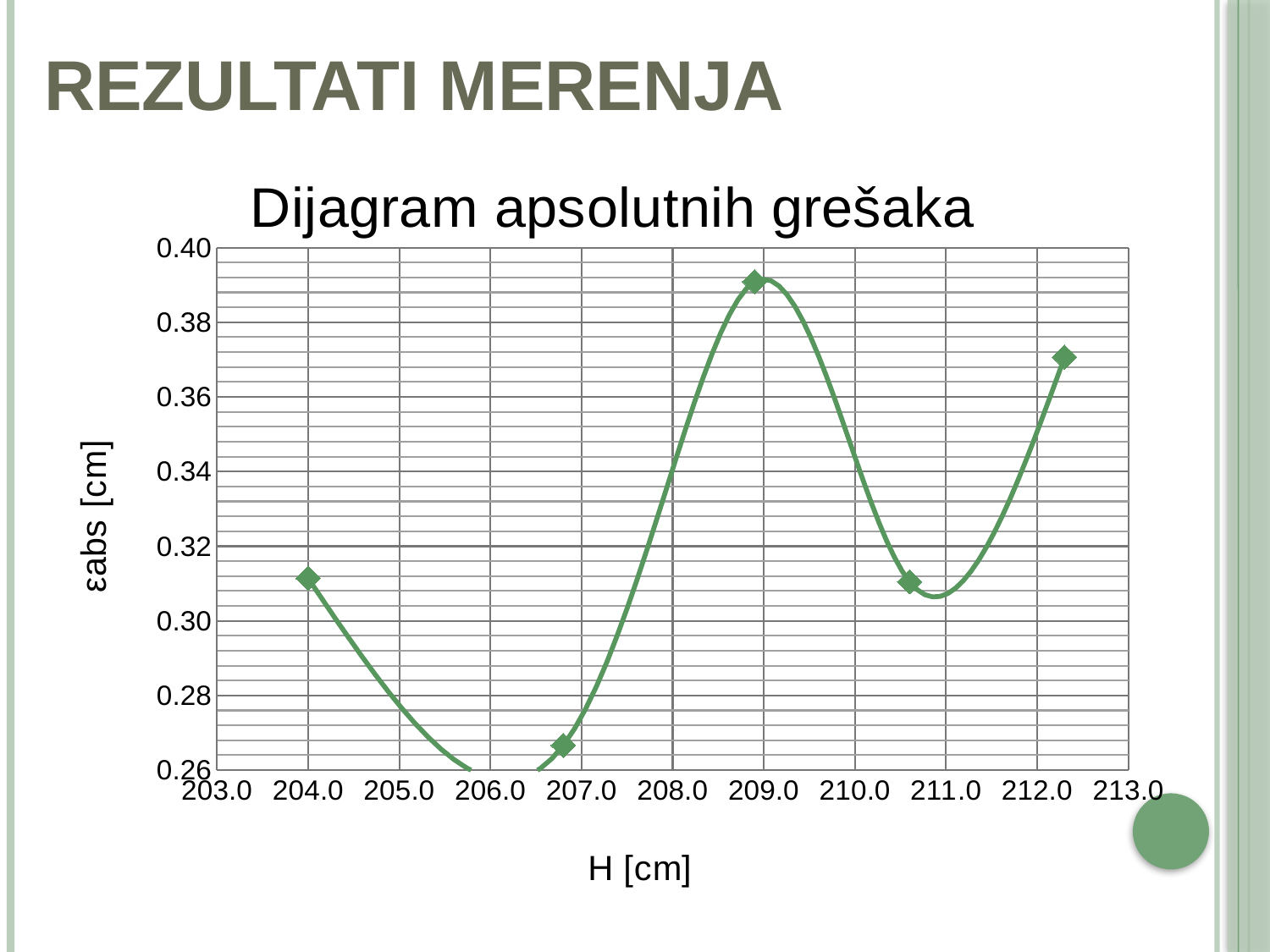
What is the H value of the leftmost data point? 204.0 Is the εabs value of the leftmost data point (H = 204.0) greater or less than 0.30? greater Which data point has the lowest εabs value: the first, second, third, fourth or fifth from the left? second Which data point has the highest εabs value: the first, second, third, fourth or fifth from the left? third What is the title of the chart? Dijagram apsolutnih grešaka What kind of chart is shown on the slide? line chart How many data points are plotted on the chart? 5 Is the εabs value of the highest data point greater or less than 0.38? greater Which has the larger εabs value: the leftmost data point or the rightmost data point? the rightmost data point Between the first and second data points from the left, does the εabs value rise or fall? fall Is the εabs value of the second data point from the left greater or less than 0.28? less What is the label of the x axis? H [cm]